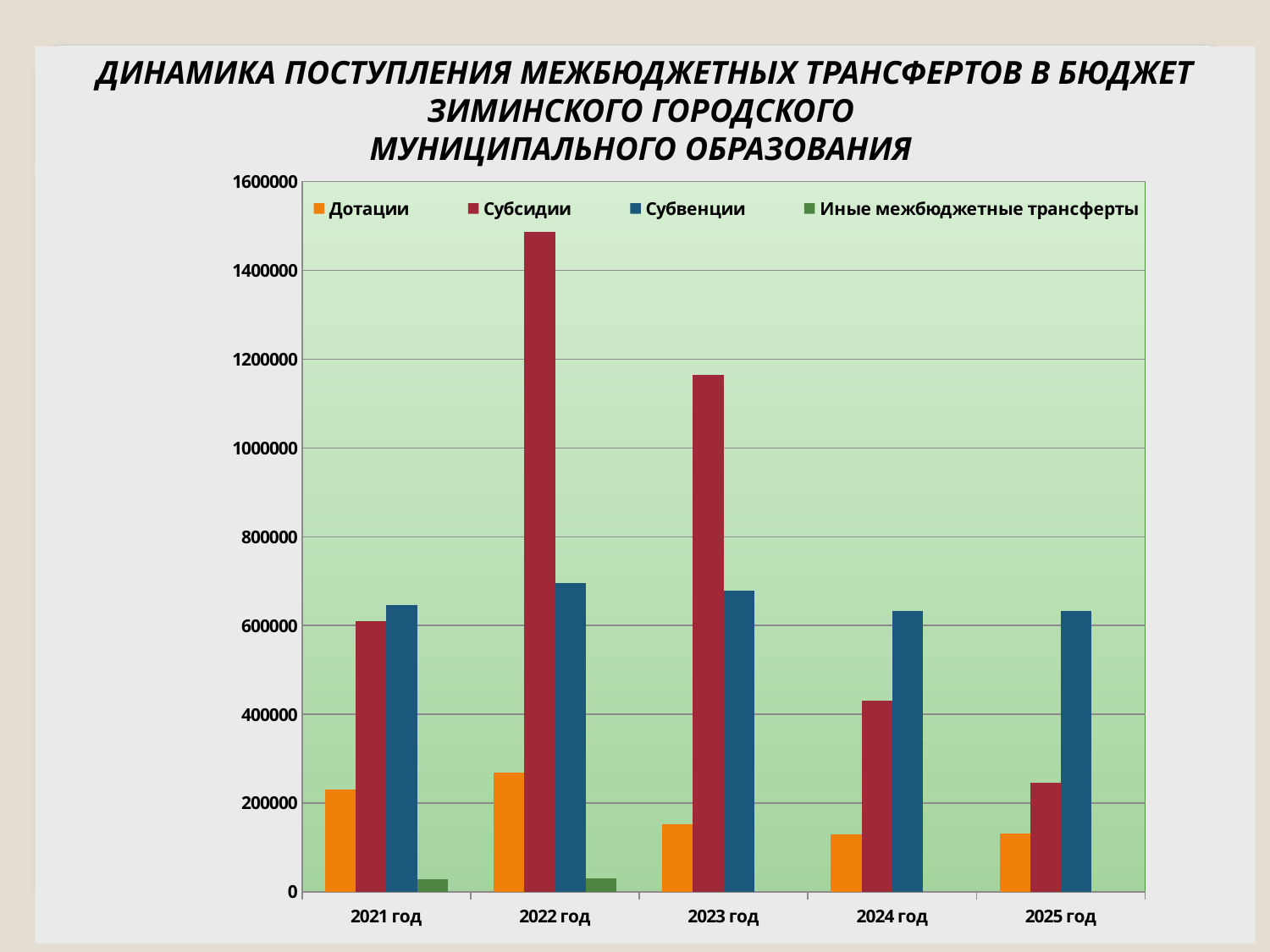
What kind of chart is shown on the slide? bar chart Is the value for Субсидии in 2022 год greater or less than 1400000? greater In 2024 год, which is larger: Субсидии or Субвенции? Субвенции Is the value for Субсидии in 2024 год greater or less than 600000? less How many years are shown on the x axis? 5 Do the values for Субсидии rise or fall from 2022 год to 2025 год? fall Is the value for Субвенции in 2021 год greater or less than 600000? greater Which series has the tallest bar in 2025 год? Субвенции In which year is the value for Субсидии the highest? 2022 год How many series does the legend list? 4 In which year is the value for Дотации the highest? 2022 год